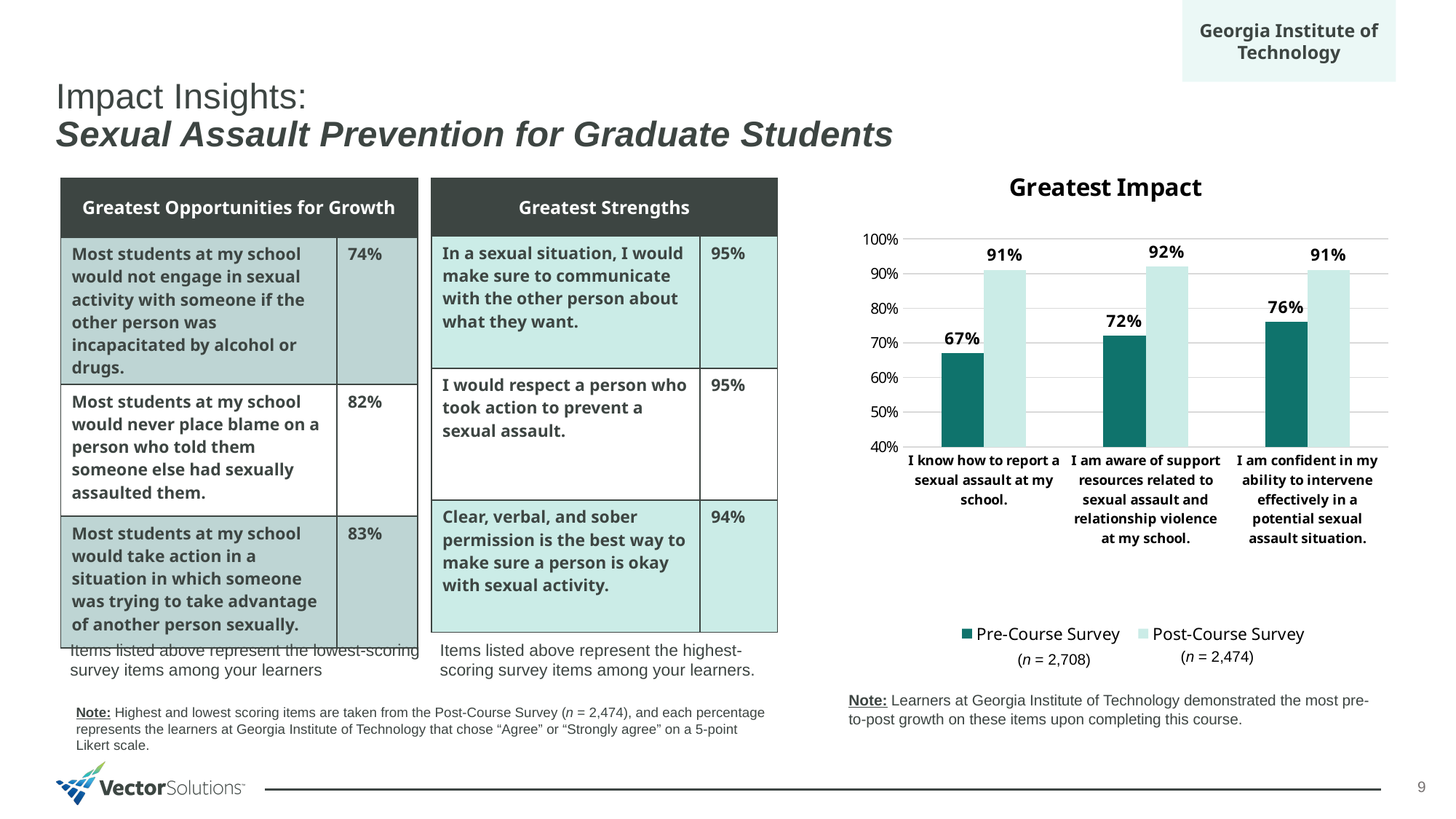
In the Greatest Impact chart, is the Pre-Course Survey value for "I know how to report a sexual assault at my school." greater or less than 70%? less How many categories are shown on the x axis of the Greatest Impact chart? 3 In the Greatest Impact chart, what is the Post-Course Survey value for "I am aware of support resources related to sexual assault and relationship violence at my school."? 92% In the Greatest Impact chart, which category has the lowest Pre-Course Survey value? I know how to report a sexual assault at my school. How many series does the legend of the Greatest Impact chart list? 2 In the Greatest Impact chart, what is the difference between the Post-Course and Pre-Course Survey values for "I know how to report a sexual assault at my school."? 24% In the Greatest Impact chart, what is the Pre-Course Survey value for "I know how to report a sexual assault at my school."? 67% In the Greatest Impact chart, what is the Pre-Course Survey value for "I am confident in my ability to intervene effectively in a potential sexual assault situation."? 76% In the Greatest Impact chart, is the Pre-Course Survey value for "I am aware of support resources related to sexual assault and relationship violence at my school." larger or smaller than the Pre-Course Survey value for "I am confident in my ability to intervene effectively in a potential sexual assault situation."? smaller What type of chart is the Greatest Impact chart? Bar chart In the Greatest Impact chart, what is the difference between the Post-Course and Pre-Course Survey values for "I am confident in my ability to intervene effectively in a potential sexual assault situation."? 15% In the Greatest Impact chart, which category has the highest Post-Course Survey value? I am aware of support resources related to sexual assault and relationship violence at my school.